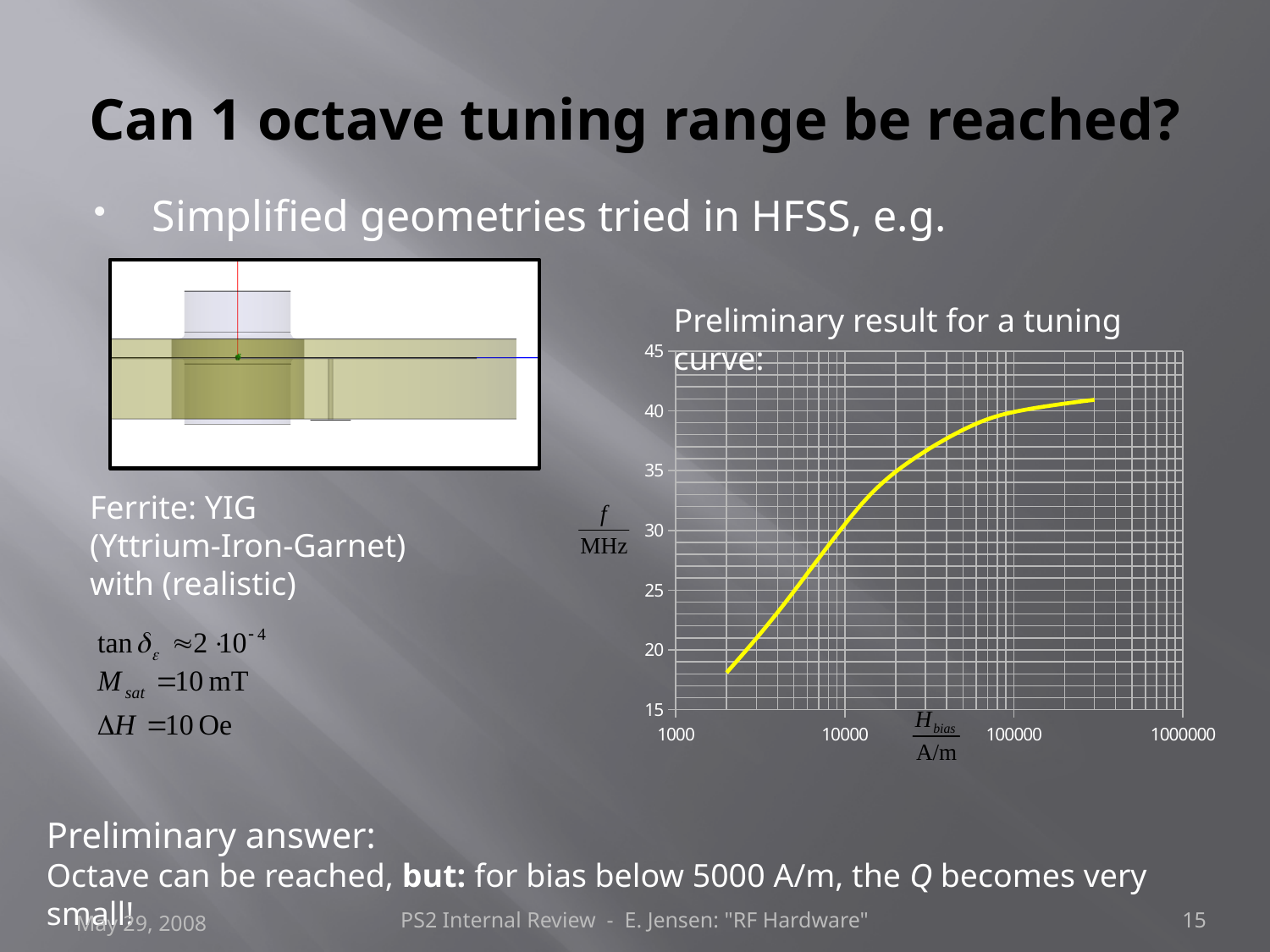
What quantity and unit are shown on the x axis of the chart? H_bias in A/m Is the value of f/MHz at H_bias = 10000 A/m greater or less than 25? greater Is the value of f/MHz at H_bias = 100000 A/m greater or less than 45? less Is the highest point of the curve greater or less than 40 MHz? greater Does the frequency f rise or fall as the bias field H_bias increases along the x axis? rises What kind of chart is shown on the slide? line chart What is the caption given above the chart? Preliminary result for a tuning curve Is the value of f at H_bias = 10000 A/m larger or smaller than the value at H_bias = 100000 A/m? smaller